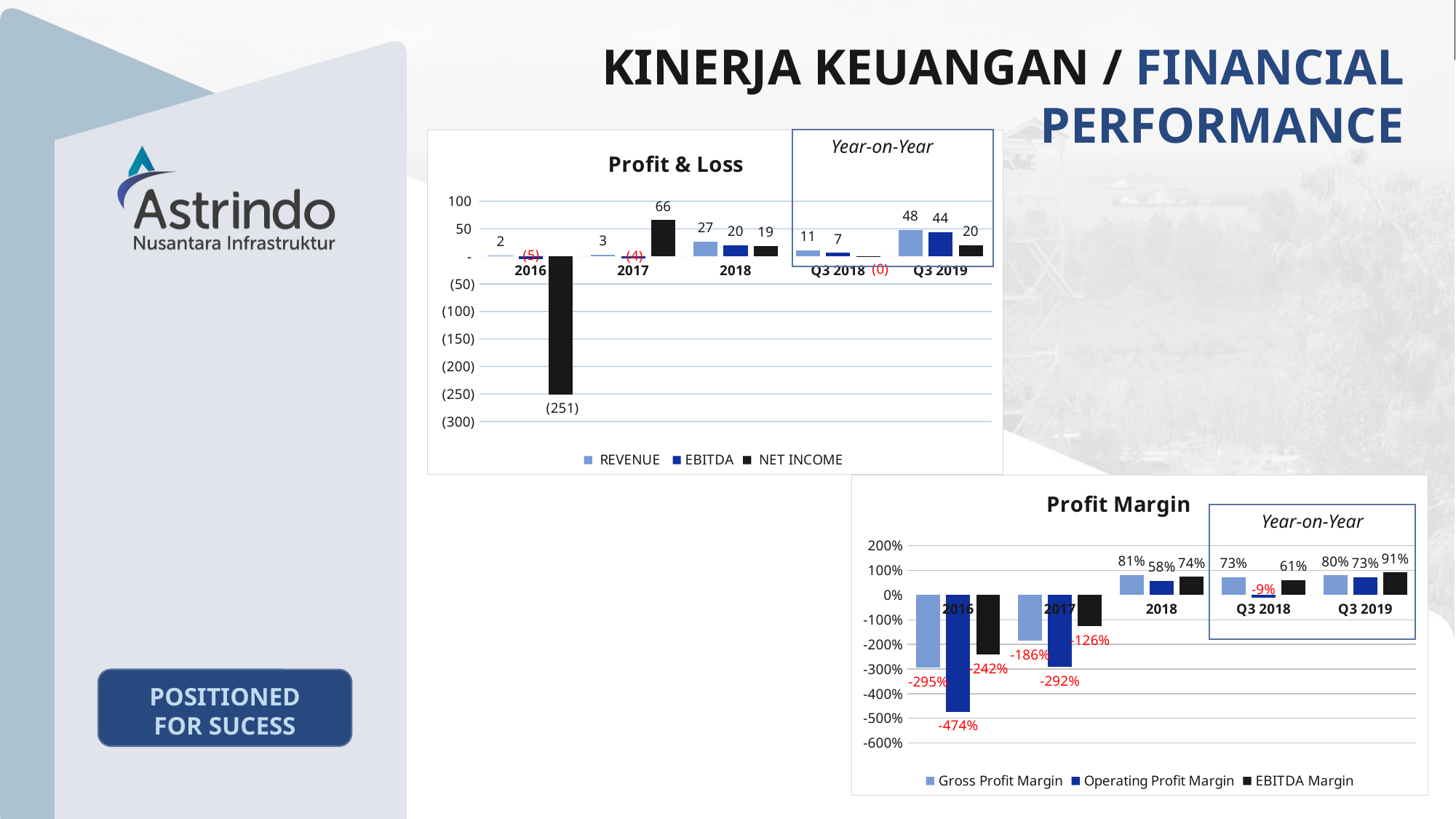
In the Profit Margin chart, what is the EBITDA Margin for Q3 2019? 91% In the Profit Margin chart, what is the Operating Profit Margin for 2016? -474% In the Profit Margin chart, is the EBITDA Margin higher in 2018 or in Q3 2019? Q3 2019 In the Profit & Loss chart, what is the difference between REVENUE in Q3 2019 and REVENUE in Q3 2018? 37 What kind of chart is the Profit & Loss chart? Bar chart In the Profit Margin chart, which period has the lowest Operating Profit Margin? 2016 In the Profit & Loss chart, what is the NET INCOME value for 2016? (251) How many series does the legend of the Profit & Loss chart list? 3 How many periods are shown on the x axis of the Profit Margin chart? 5 In the Profit & Loss chart, which period has the highest NET INCOME? 2017 In the Profit Margin chart, what is the difference between the EBITDA Margin in Q3 2019 and in Q3 2018? 30 percentage points In the Profit & Loss chart, what is the REVENUE value for Q3 2019? 48